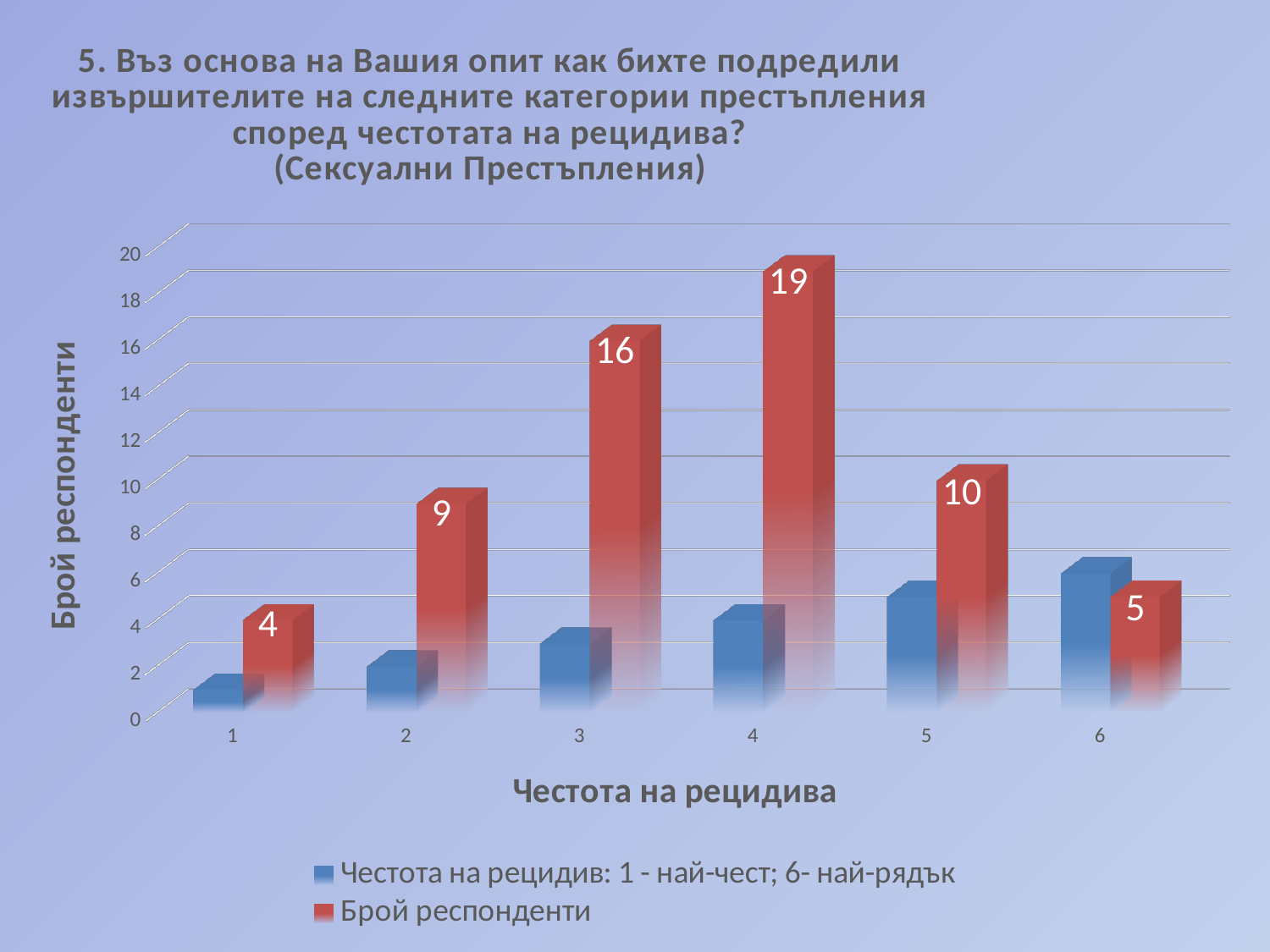
How many categories are shown on the x axis? 6 What is the value of "Брой респонденти" for category 2? 9 Which category has the lowest value for "Брой респонденти"? 1 What is the value of "Брой респонденти" for category 6? 5 Which has a larger "Брой респонденти" value, category 5 or category 2? 5 How many series does the legend list? 2 Which category has the highest value for "Брой респонденти"? 4 What is the title of the vertical axis? Брой респонденти What is the value of "Брой респонденти" for category 4? 19 Is the value of the blue series for category 6 greater or less than 4? greater What is the difference between the "Брой респонденти" values for categories 4 and 3? 3 What kind of chart is shown on the slide? bar chart